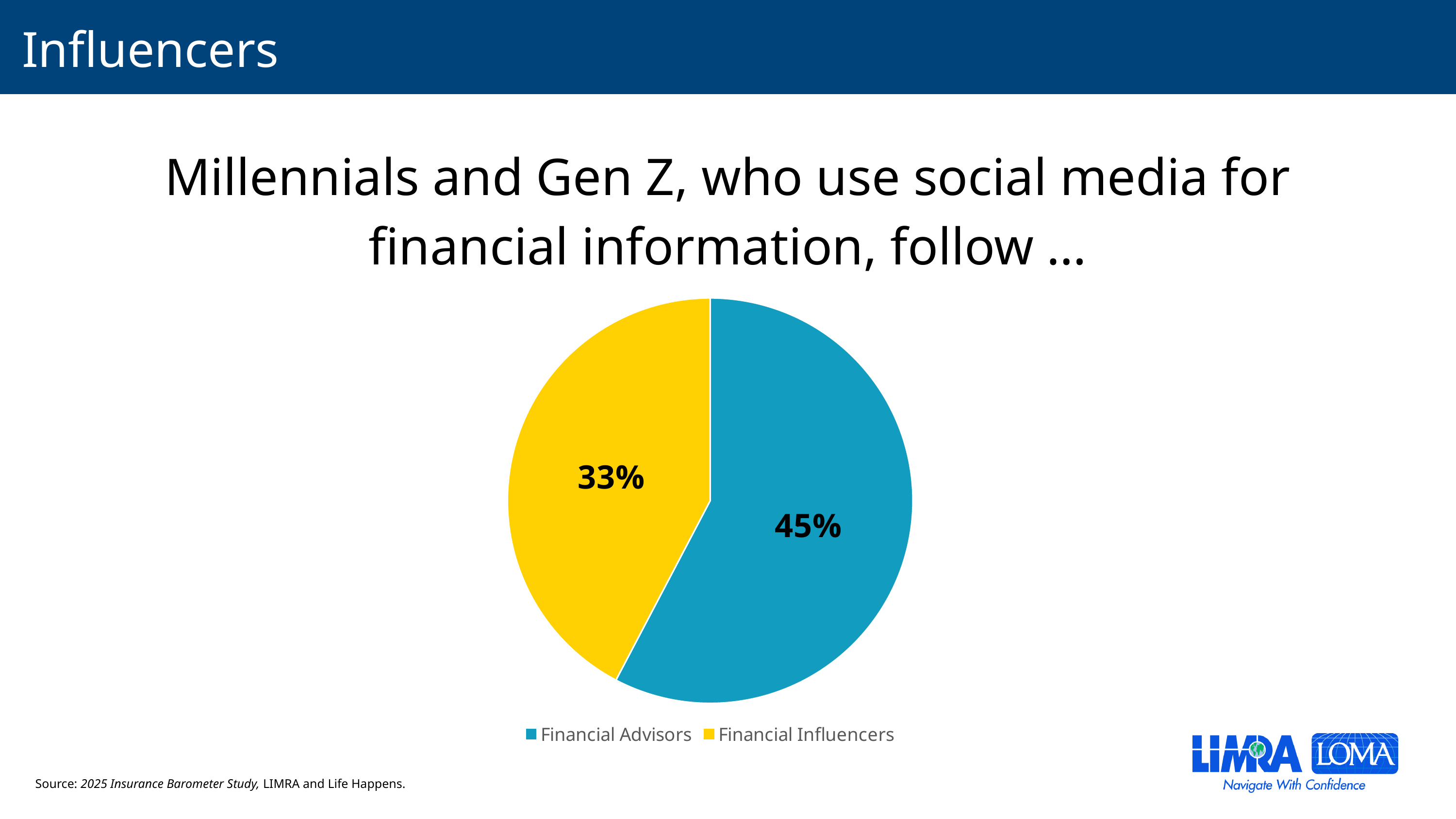
Which slice of the pie chart is the largest? Financial Advisors Which slice of the pie chart is the smallest? Financial Influencers What is the difference in percentage points between the Financial Advisors and Financial Influencers slices? 12 What kind of chart is shown on the slide? Pie chart What percentage of the pie chart is labelled for Financial Influencers? 33% How many entries does the legend list? 2 What percentage of the pie chart is labelled for Financial Advisors? 45% What colour is the Financial Advisors slice? Blue How many slices does the pie chart have? 2 What colour is the Financial Influencers slice? Yellow Which is larger, the Financial Advisors slice or the Financial Influencers slice? Financial Advisors